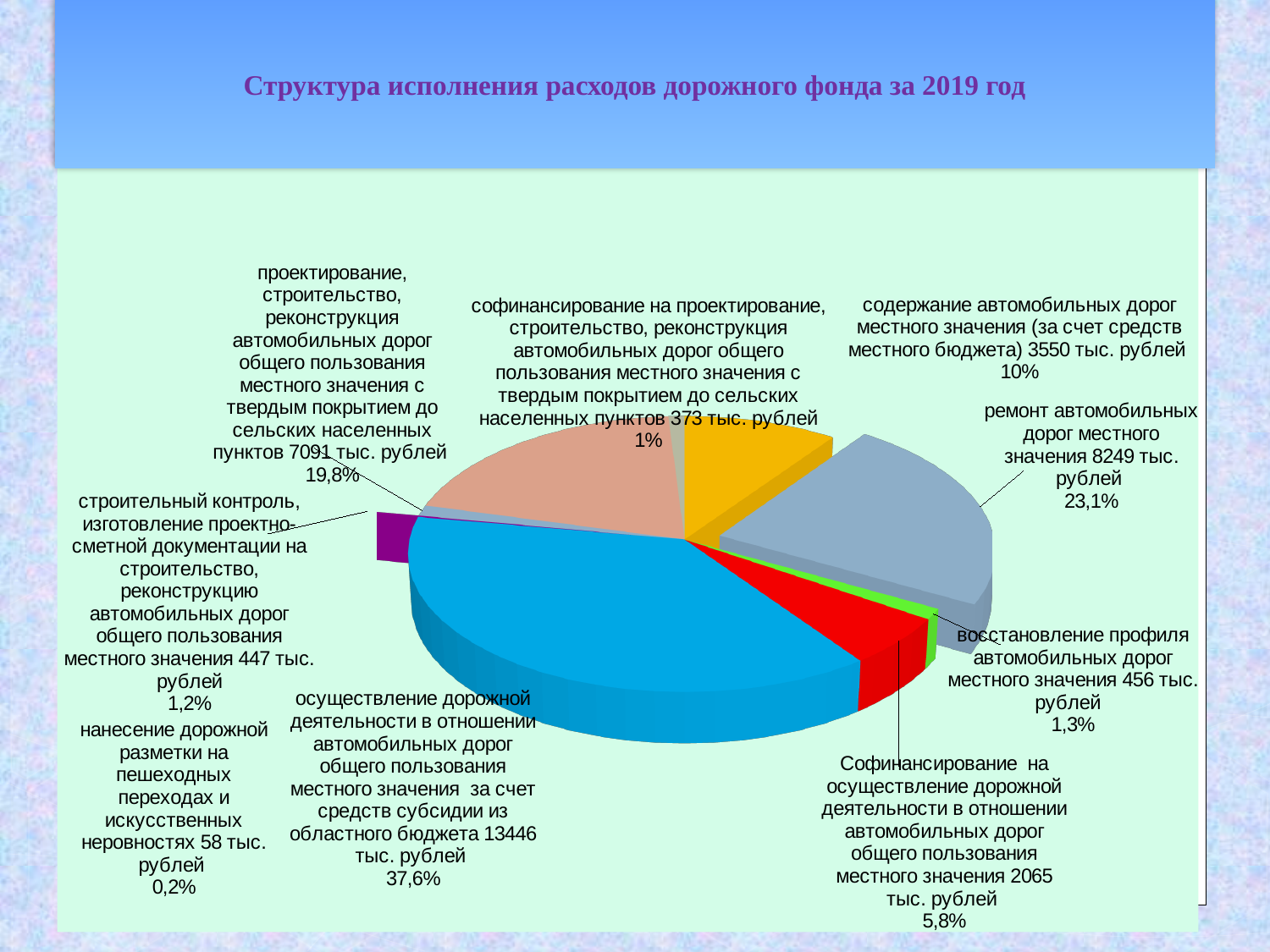
Which category has the smallest share of the pie? нанесение дорожной разметки на пешеходных переходах и искусственных неровностях What is the title of the chart? Структура исполнения расходов дорожного фонда за 2019 год How many slices (categories) does the pie chart have? 9 Which category has the largest share of the pie? осуществление дорожной деятельности в отношении автомобильных дорог общего пользования местного значения за счет средств субсидии из областного бюджета What share of the pie does 'Софинансирование на осуществление дорожной деятельности в отношении автомобильных дорог общего пользования местного значения' have? 5,8% What amount in тыс. рублей is shown for 'восстановление профиля автомобильных дорог местного значения'? 456 тыс. рублей Which is larger: the share for 'ремонт автомобильных дорог местного значения' or the share for 'проектирование, строительство, реконструкция автомобильных дорог ... до сельских населенных пунктов'? ремонт автомобильных дорог местного значения What is the difference in тыс. рублей between 'ремонт автомобильных дорог местного значения' (8249) and 'содержание автомобильных дорог местного значения' (3550)? 4699 тыс. рублей What share of the pie does 'ремонт автомобильных дорог местного значения' have? 23,1% What kind of chart is shown on the slide? pie chart What amount in тыс. рублей is shown for 'осуществление дорожной деятельности ... за счет средств субсидии из областного бюджета'? 13446 тыс. рублей What share of the pie does 'содержание автомобильных дорог местного значения (за счет средств местного бюджета)' have? 10%